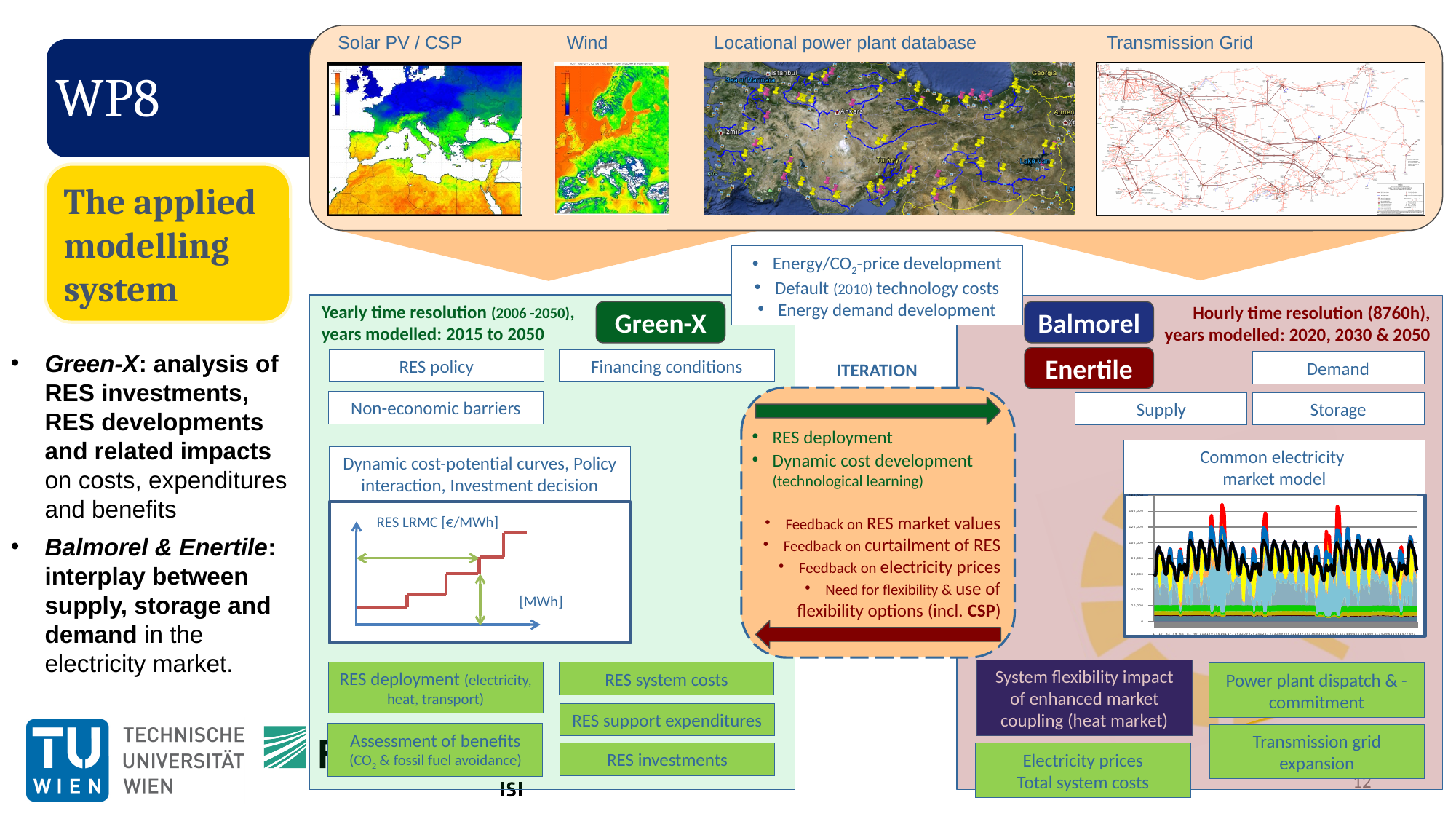
In the chart inside the Green-X box, do the values of the red curve rise or fall along the x axis? rise What is the title of the chart shown on the right side of the slide, inside the Balmorel/Enertile area? Common electricity market model What kind of chart is shown inside the Green-X box on the left (the one with the RES LRMC axis)? line chart What is the label on the vertical axis of the chart inside the Green-X box? RES LRMC [€/MWh]